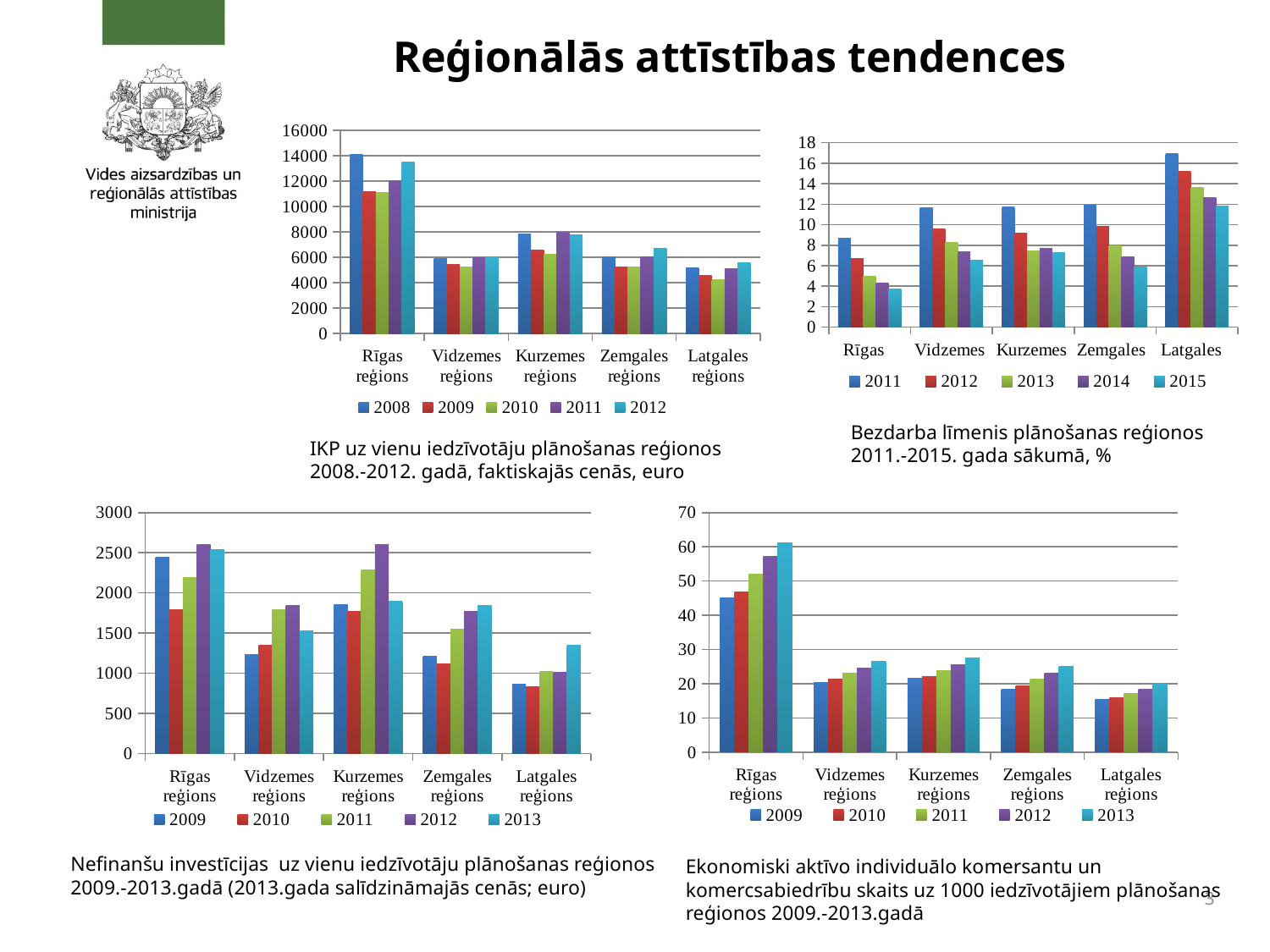
In the top-left chart (IKP uz vienu iedzīvotāju), is the value for Rīgas reģions in 2008 greater or less than 12000? greater In the bottom-left chart (Nefinanšu investīcijas), which is larger: Rīgas reģions in 2009 or Vidzemes reģions in 2009? Rīgas reģions in 2009 In the top-left chart (IKP uz vienu iedzīvotāju), which region has the highest bar for 2008? Rīgas reģions In the top-right chart (Bezdarba līmenis), which region has the highest unemployment bar in 2011? Latgales In the bottom-right chart (Ekonomiski aktīvo individuālo komersantu), is the value for Rīgas reģions in 2013 greater or less than 60? greater In the bottom-right chart (Ekonomiski aktīvo individuālo komersantu), do the values for Rīgas reģions rise or fall from 2009 to 2013? rise In the top-left chart (IKP uz vienu iedzīvotāju), how many series does the legend list? 5 What type of chart is the bottom-right chart (Ekonomiski aktīvo individuālo komersantu)? bar chart In the top-right chart (Bezdarba līmenis), how many regions are shown on the x axis? 5 In the top-right chart (Bezdarba līmenis), do the values for Latgales rise or fall from 2011 to 2015? fall In the bottom-left chart (Nefinanšu investīcijas), is the value for Latgales reģions in 2010 greater or less than 1000? less